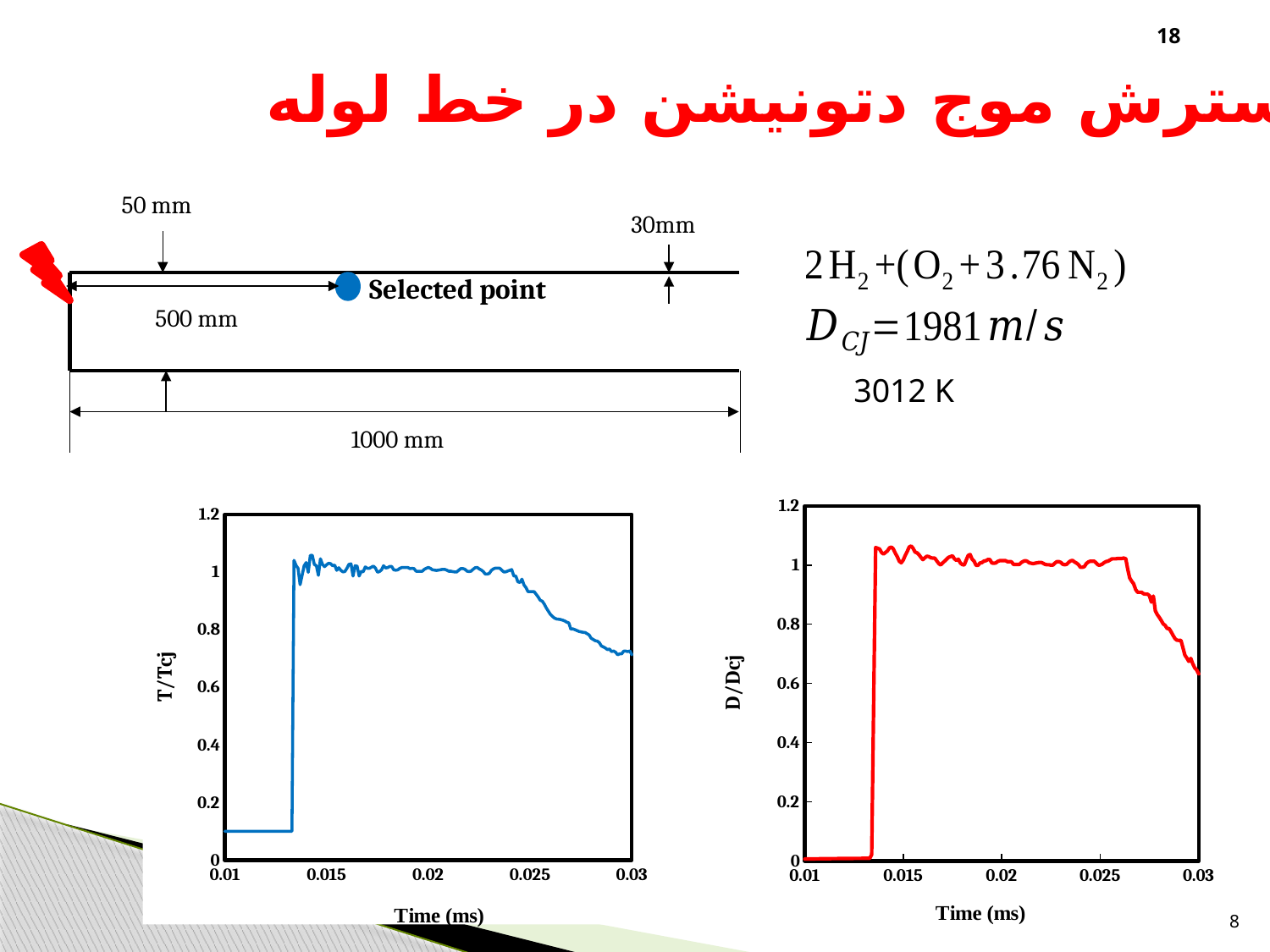
In the right chart (D/Dcj), is the value at 0.03 ms greater or less than 0.8? less In the right chart (D/Dcj), do the values rise or fall between 0.025 ms and 0.03 ms? fall In the left chart (T/Tcj), is the value at 0.02 ms greater or less than 0.8? greater In the left chart (T/Tcj), do the values rise or fall between 0.025 ms and 0.03 ms? fall What kind of chart is the right chart with the y-axis labelled D/Dcj? line chart In the left chart (T/Tcj), is the value at 0.03 ms greater or less than 0.8? less What is the x-axis label of the right chart (D/Dcj)? Time (ms) What kind of chart is the left chart with the y-axis labelled T/Tcj? line chart What colour is the line in the right chart (D/Dcj)? red